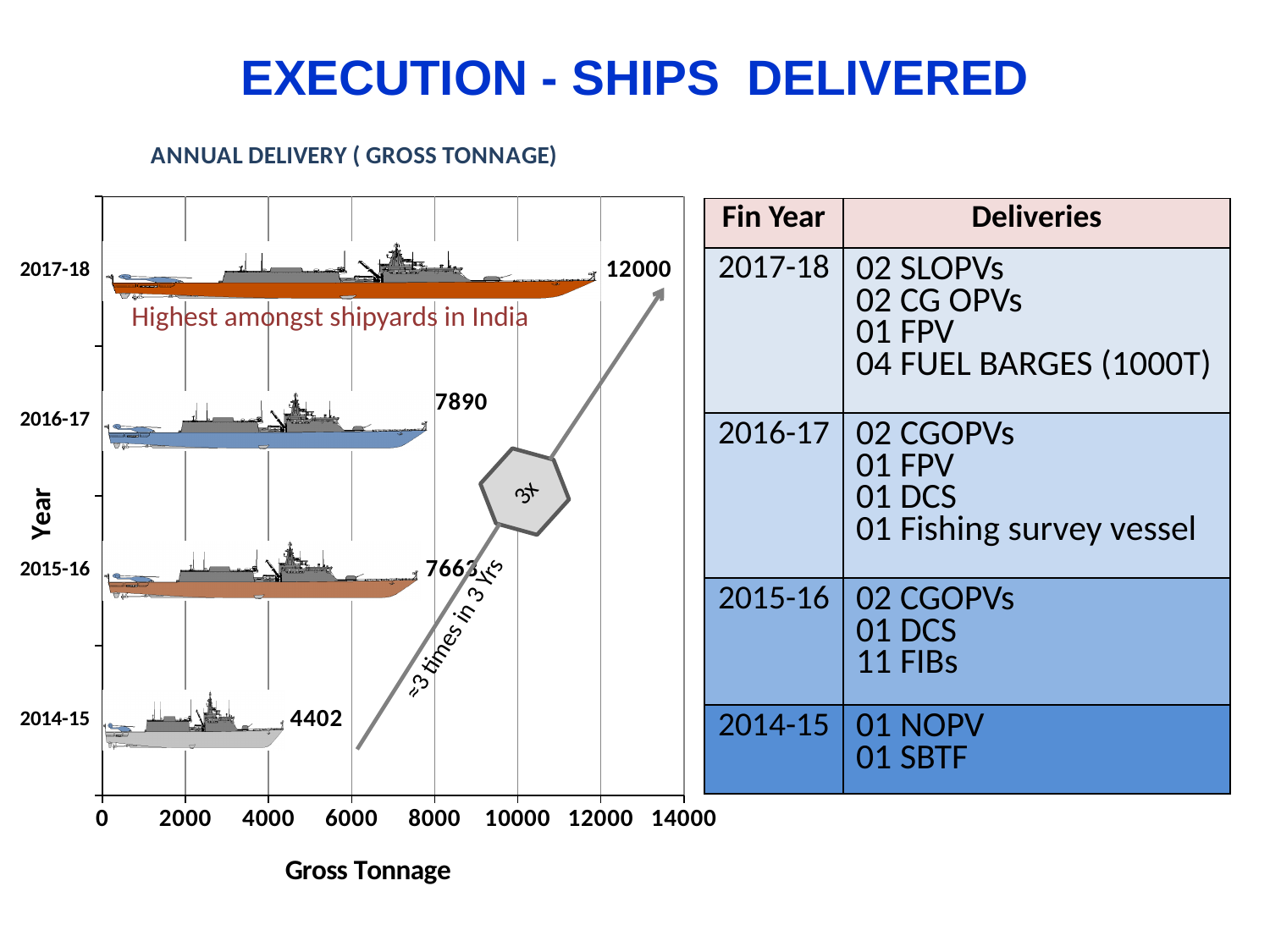
What is the difference in gross tonnage between 2017-18 and 2016-17? 4110 How many financial years are shown in the chart? 4 Which year has the highest gross tonnage delivered? 2017-18 What is the difference in gross tonnage between 2017-18 and 2014-15? 7598 Is the gross tonnage for 2015-16 greater or less than 6000? greater What is the title of the chart? ANNUAL DELIVERY ( GROSS TONNAGE) What is the gross tonnage delivered in 2016-17? 7890 What is the gross tonnage delivered in 2014-15? 4402 Which year has a larger gross tonnage, 2016-17 or 2014-15? 2016-17 What is the gross tonnage delivered in 2017-18? 12000 Which year has the lowest gross tonnage delivered? 2014-15 What type of chart is used to show annual delivery? Bar chart